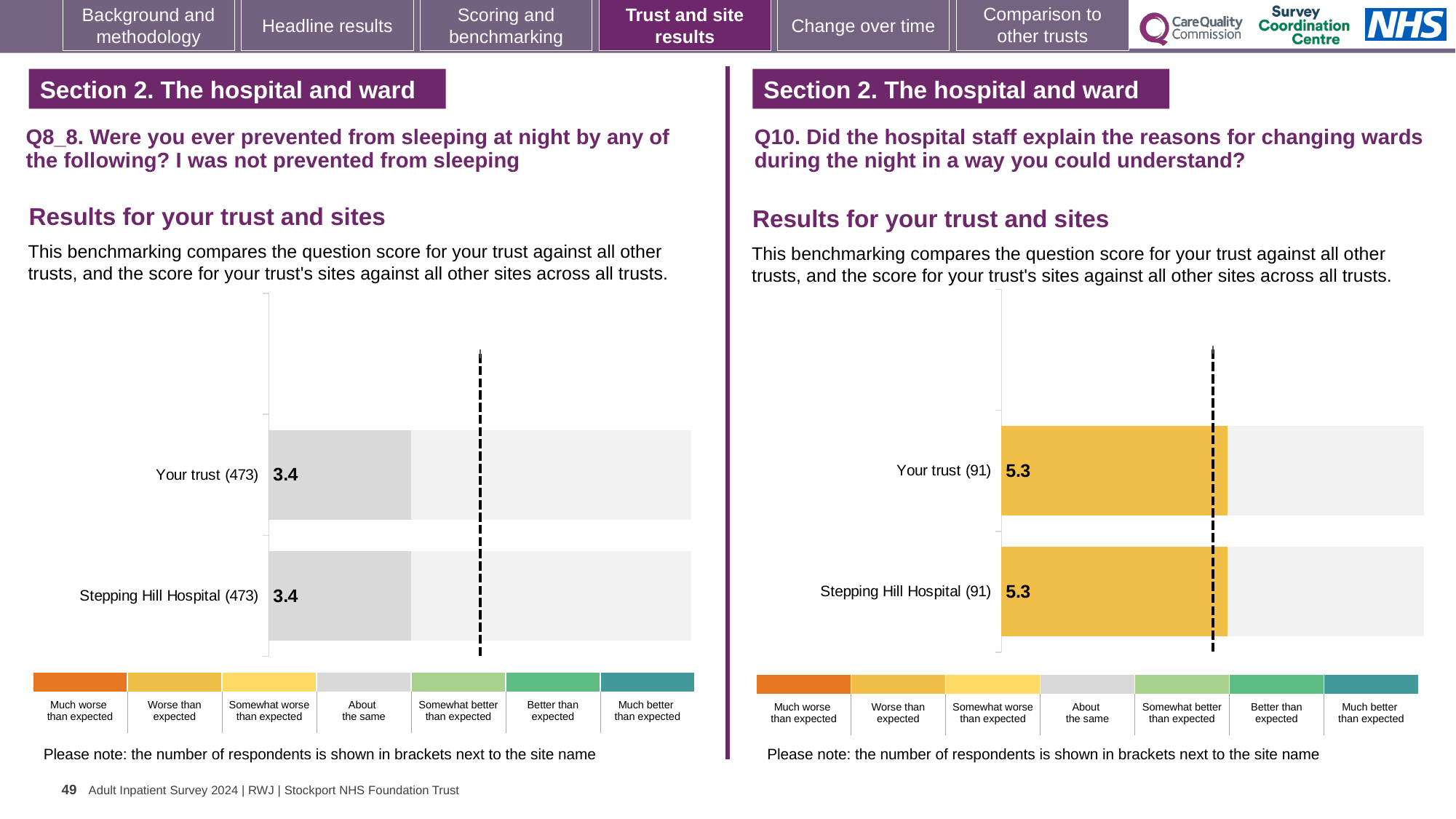
In the right chart (Q10), what is the score for Stepping Hill Hospital? 5.3 In the right chart (Q10), what is the difference between the score for Your trust and the score for Stepping Hill Hospital? 0.0 How many bars are plotted in the left chart (Q8_8)? 2 In the left chart (Q8_8), what is the score for Stepping Hill Hospital? 3.4 In the right chart (Q10), what is the score for Your trust? 5.3 What kind of chart is used in the right chart (Q10)? Bar chart In the left chart (Q8_8), what is the score for Your trust? 3.4 In the right chart (Q10), how many respondents are shown in brackets for Stepping Hill Hospital? 91 In the left chart (Q8_8), how many respondents are shown in brackets for Your trust? 473 In the left chart (Q8_8), what is the difference between the score for Your trust and the score for Stepping Hill Hospital? 0.0 In the right chart (Q10), which benchmark category does the colour of the bars correspond to according to the legend? Worse than expected How many bars are plotted in the right chart (Q10)? 2